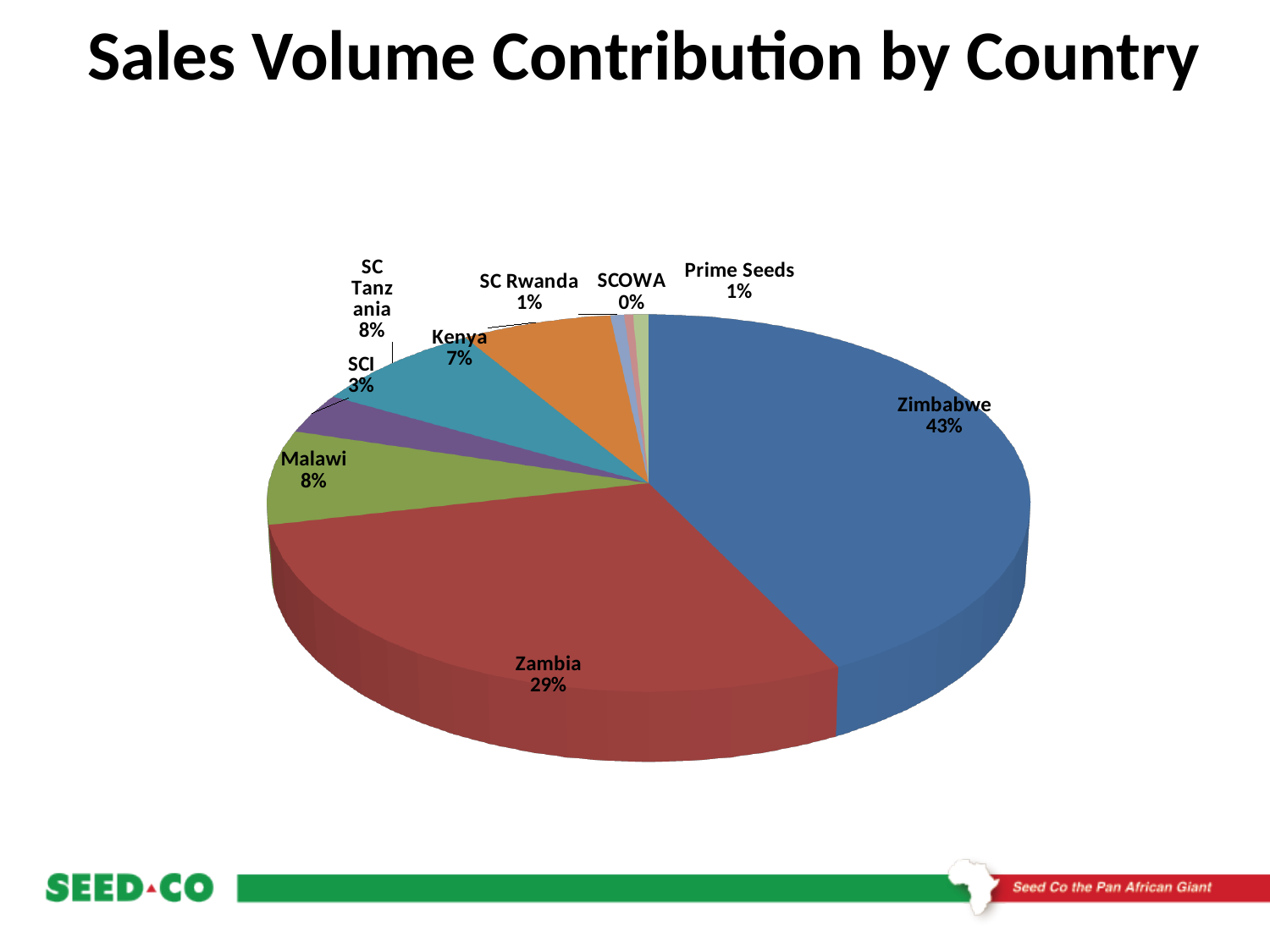
What percentage is shown for Kenya? 7% What share of sales volume does Zambia contribute? 29% Which has a larger share, Malawi or Kenya? Malawi How many slices does the pie chart have? 9 What share of sales volume does Zimbabwe contribute? 43% What is the combined share of Zimbabwe and Zambia? 72% Which slice has the smallest share of sales volume? SCOWA What kind of chart is shown on the slide? Pie chart Which country has the largest share of sales volume? Zimbabwe What percentage is shown for SCI? 3% What is the title of the chart? Sales Volume Contribution by Country What is the difference in percentage points between Zimbabwe's and Zambia's shares? 14